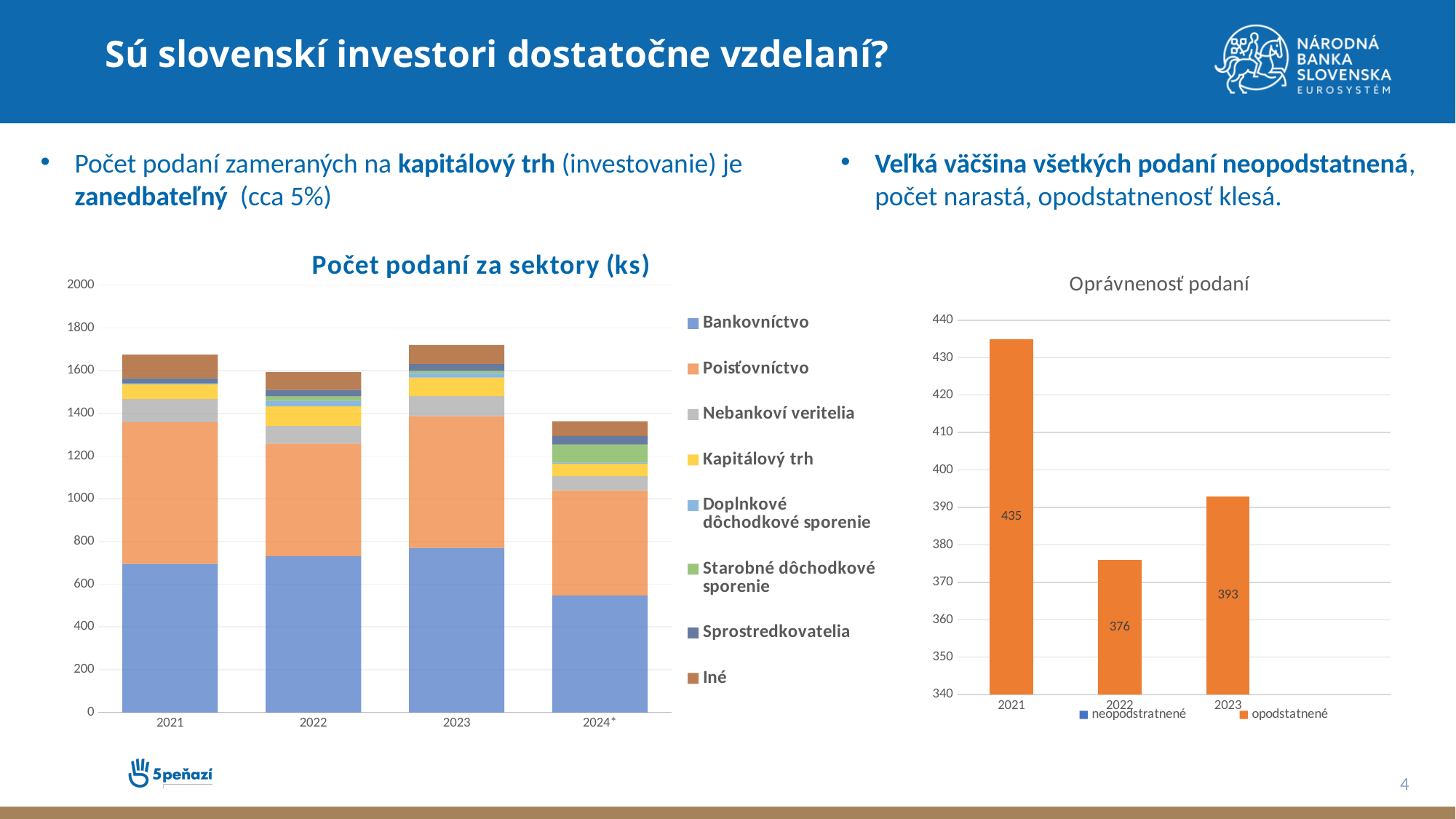
In the 'Počet podaní za sektory (ks)' chart, how many series does the legend list? 8 What kind of chart is 'Počet podaní za sektory (ks)'? stacked bar chart In the 'Počet podaní za sektory (ks)' chart, is the total for 2023 greater or less than 1600? greater In the 'Oprávnenosť podaní' chart, how many series does the legend list? 2 In the 'Oprávnenosť podaní' chart, which is larger, the value for 2022 or for 2023? 2023 In the 'Oprávnenosť podaní' chart, what is the value for 2022? 376 In the 'Oprávnenosť podaní' chart, what is the difference between the 2021 and 2022 values? 59 In the 'Oprávnenosť podaní' chart, what is the value for 2021? 435 In the 'Oprávnenosť podaní' chart, which year has the lowest value? 2022 In the 'Počet podaní za sektory (ks)' chart, which year has the lowest total bar? 2024* In the 'Oprávnenosť podaní' chart, which year has the highest value? 2021 In the 'Oprávnenosť podaní' chart, what is the value for 2023? 393